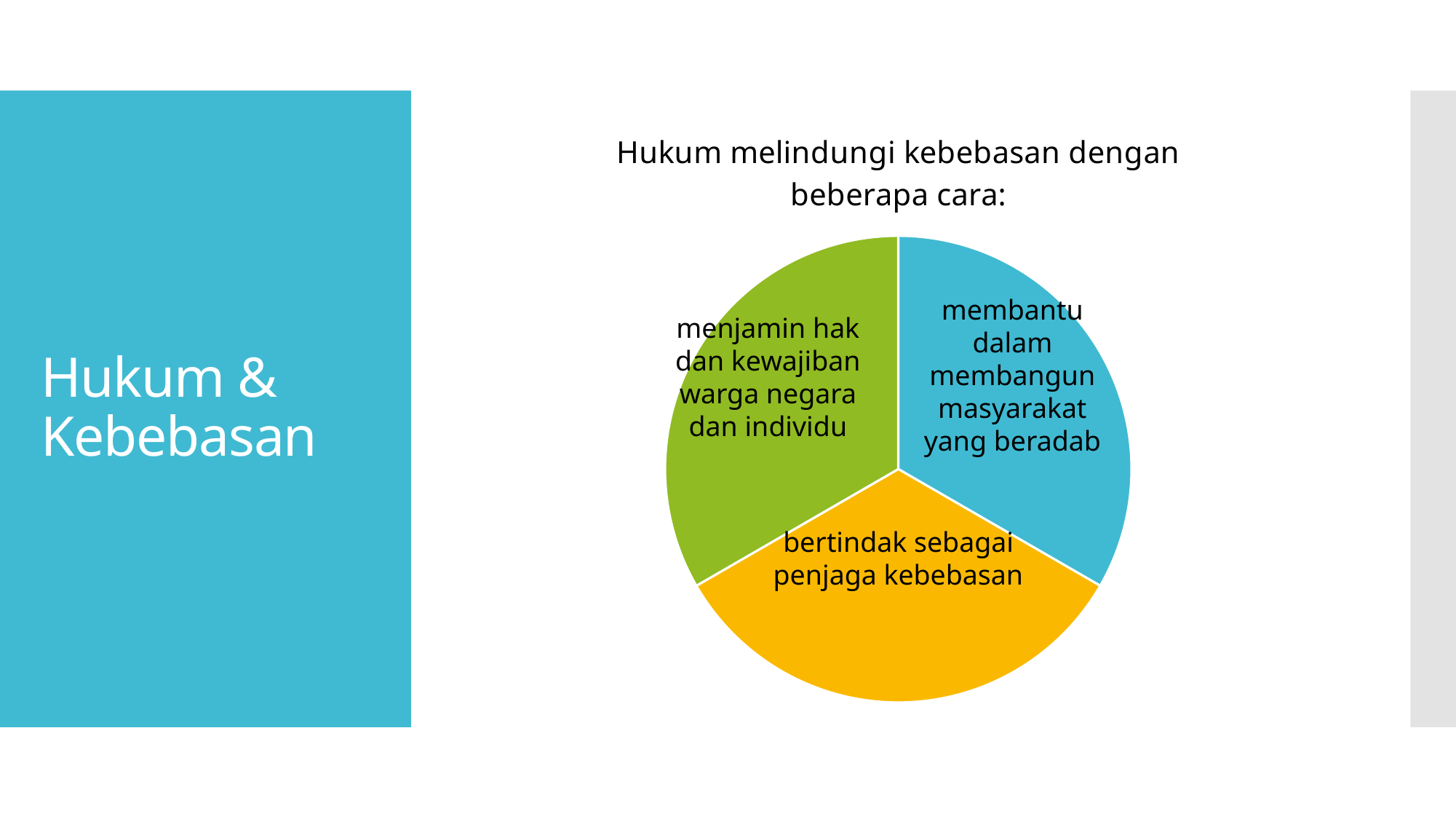
What is the label of the yellow slice at the bottom of the pie chart? bertindak sebagai penjaga kebebasan Which slice of the pie chart is coloured green? menjamin hak dan kewajiban warga negara dan individu What is the label of the blue slice of the pie chart? membantu dalam membangun masyarakat yang beradab What is the title shown above the pie chart? Hukum melindungi kebebasan dengan beberapa cara: How many slices does the pie chart have? 3 What kind of chart is shown on the slide? pie chart